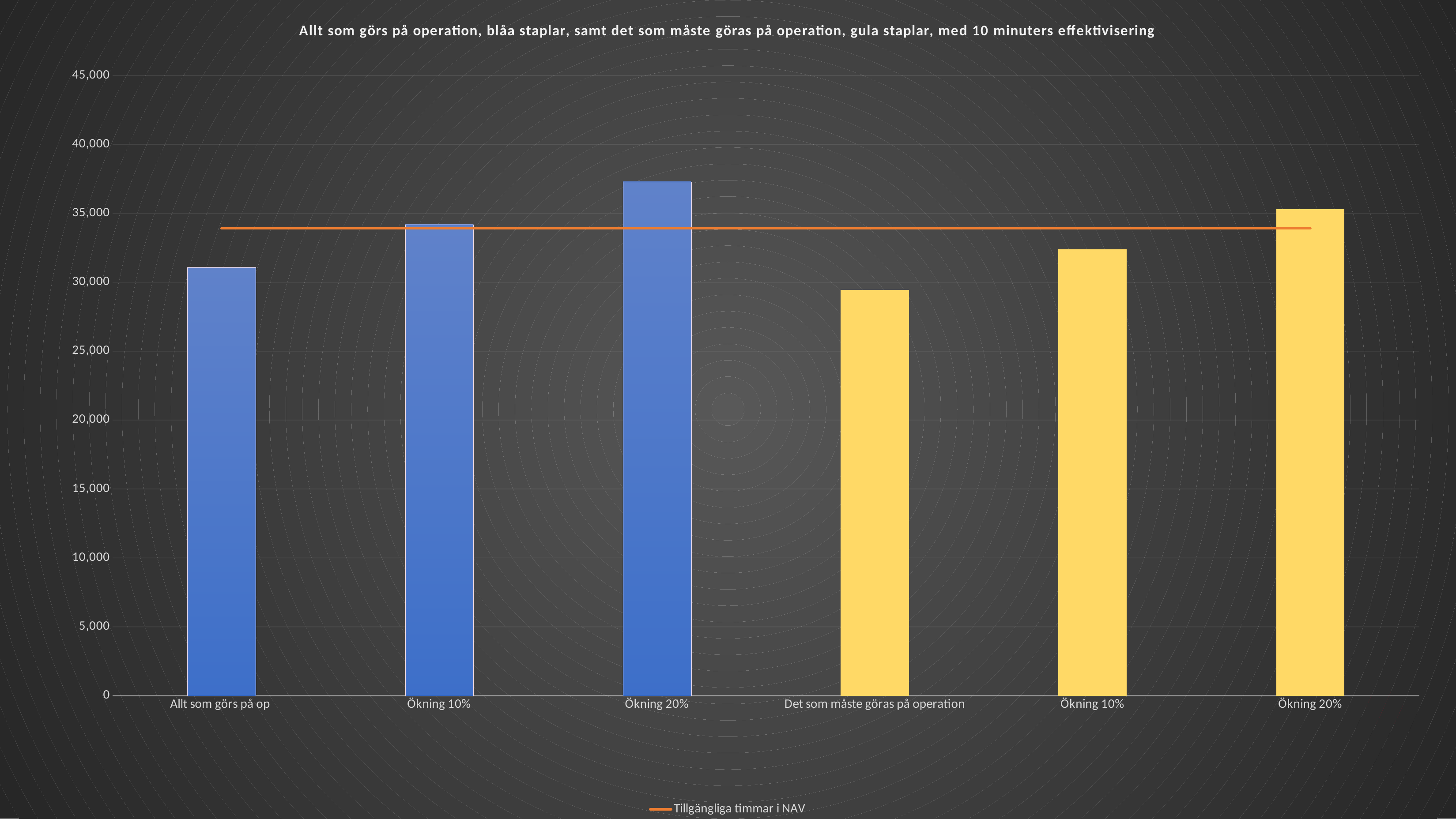
Which is larger, the blue Ökning 10% bar or the yellow Ökning 10% bar? the blue Ökning 10% bar How many bars are plotted in the chart? 6 Do the blue bars rise or fall from Allt som görs på op to Ökning 20%? rise Is the value for Det som måste göras på operation greater or less than 30,000? less What is the name of the series shown in the legend? Tillgängliga timmar i NAV What colour is the horizontal line for Tillgängliga timmar i NAV? orange What kind of chart is shown on the slide? bar chart How many entries does the legend list? 1 Is the value for Allt som görs på op greater or less than 30,000? greater Which bar is the lowest in the chart? Det som måste göras på operation Which bar is the highest in the chart? Ökning 20% (blue bar) Is the value of the blue Ökning 20% bar greater or less than 35,000? greater